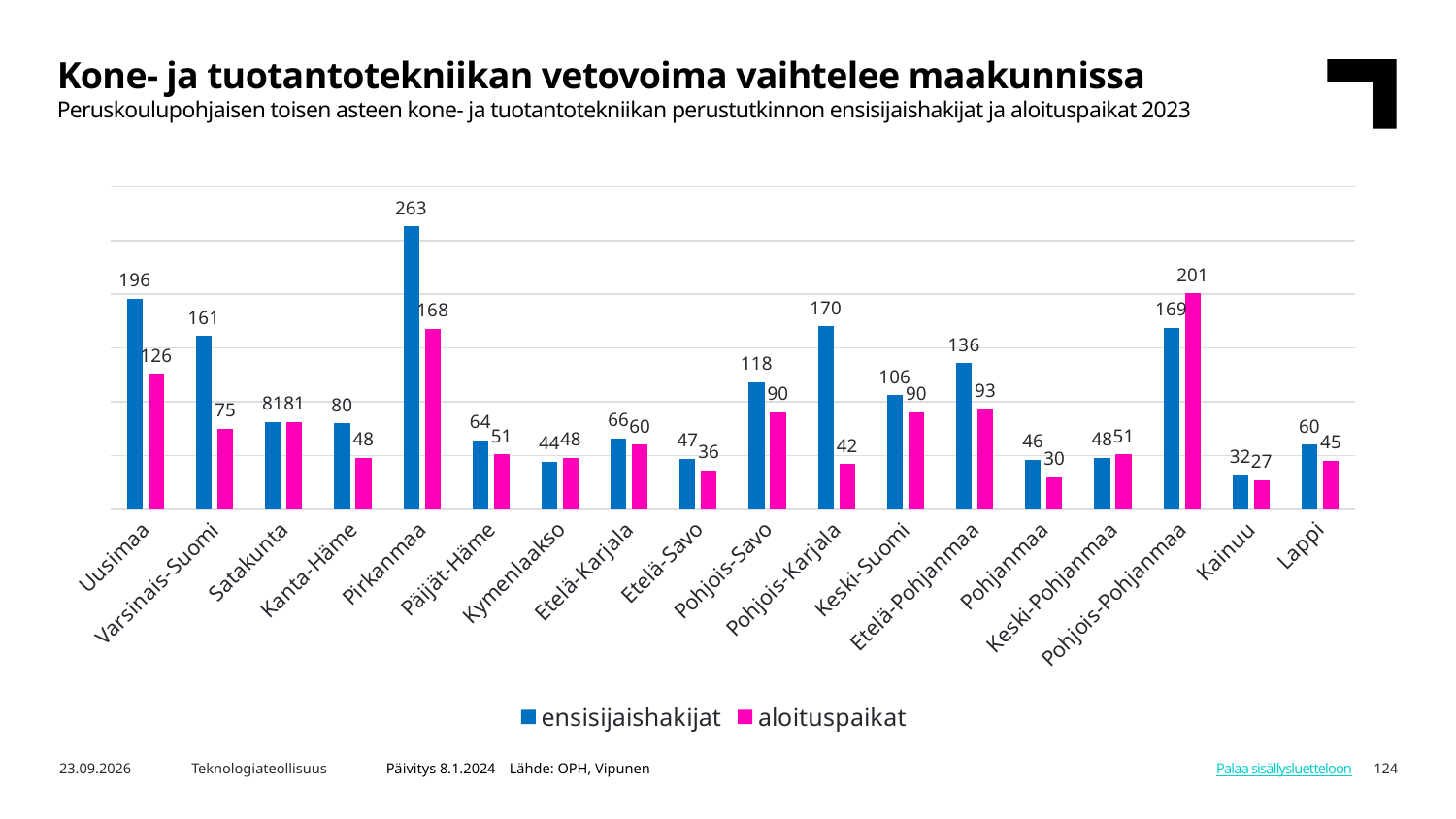
Which series is shown in pink in the legend? aloituspaikat Which is larger for Pohjois-Pohjanmaa, ensisijaishakijat or aloituspaikat? aloituspaikat What is the value of aloituspaikat for Pohjois-Karjala? 42 What is the difference between ensisijaishakijat for Uusimaa and Varsinais-Suomi? 35 How many regions are shown on the x axis? 18 Which region has the highest value of ensisijaishakijat? Pirkanmaa What is the value of ensisijaishakijat for Pirkanmaa? 263 What kind of chart is shown on the slide? bar chart Which region has the lowest value of aloituspaikat? Kainuu What is the difference between ensisijaishakijat and aloituspaikat for Pohjois-Karjala? 128 What is the value of aloituspaikat for Uusimaa? 126 How many series does the legend list? 2